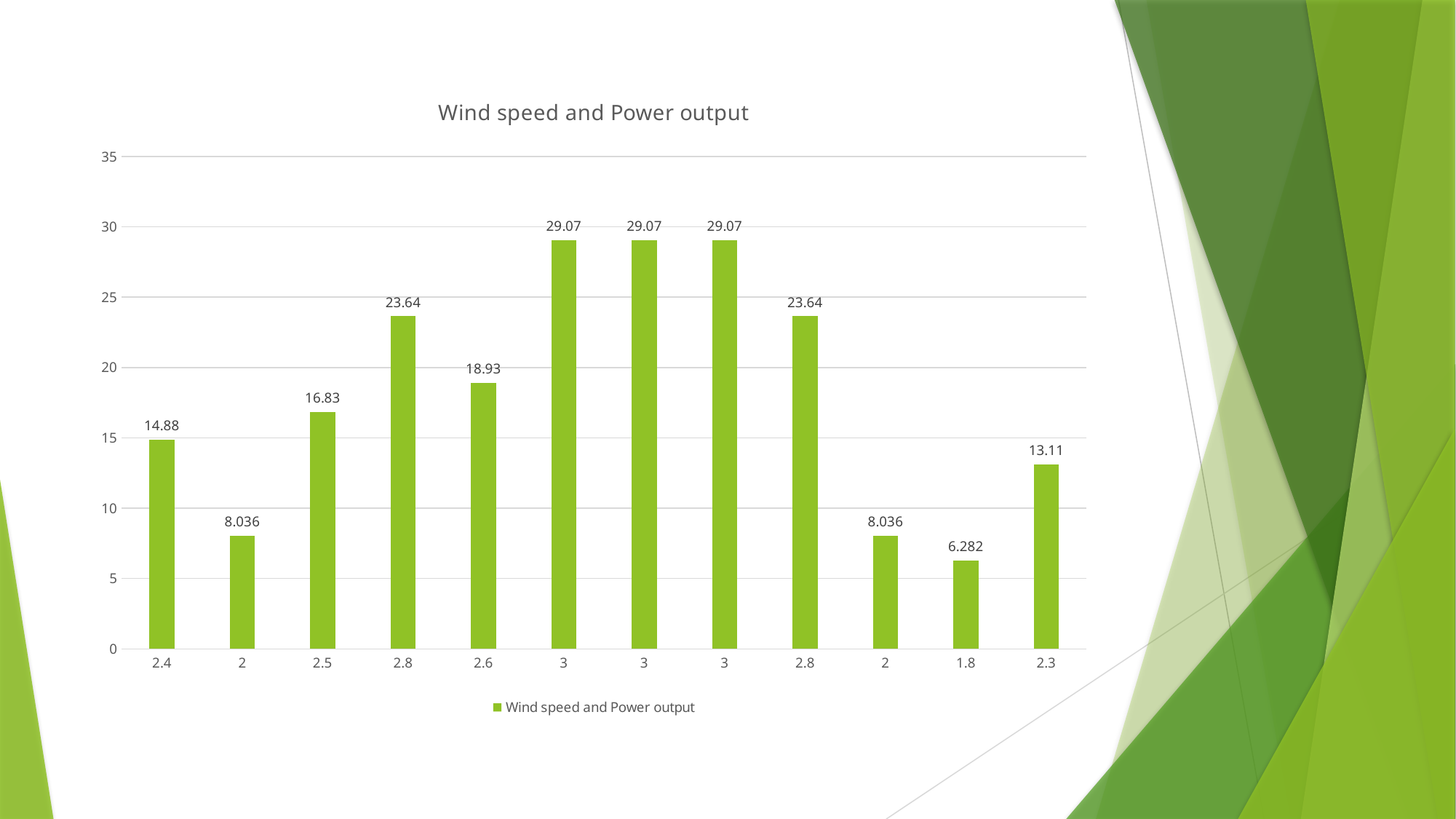
What is the value of the bar labelled 2.6? 18.93 Which has a larger value, the bar labelled 2.4 or the bar labelled 2.3? 2.4 How many bars are plotted on the chart? 12 What is the highest value shown on the chart? 29.07 Is the value for 2.6 greater or less than 20? less What type of chart is shown on the slide? bar chart What value is shown for the bars labelled 3? 29.07 How many series does the legend list? 1 What is the value of the bar labelled 2.4? 14.88 What is the difference between the values for 2.5 and 2.3? 3.72 What is the value of the bar labelled 1.8? 6.282 Which x-axis category has the lowest bar? 1.8